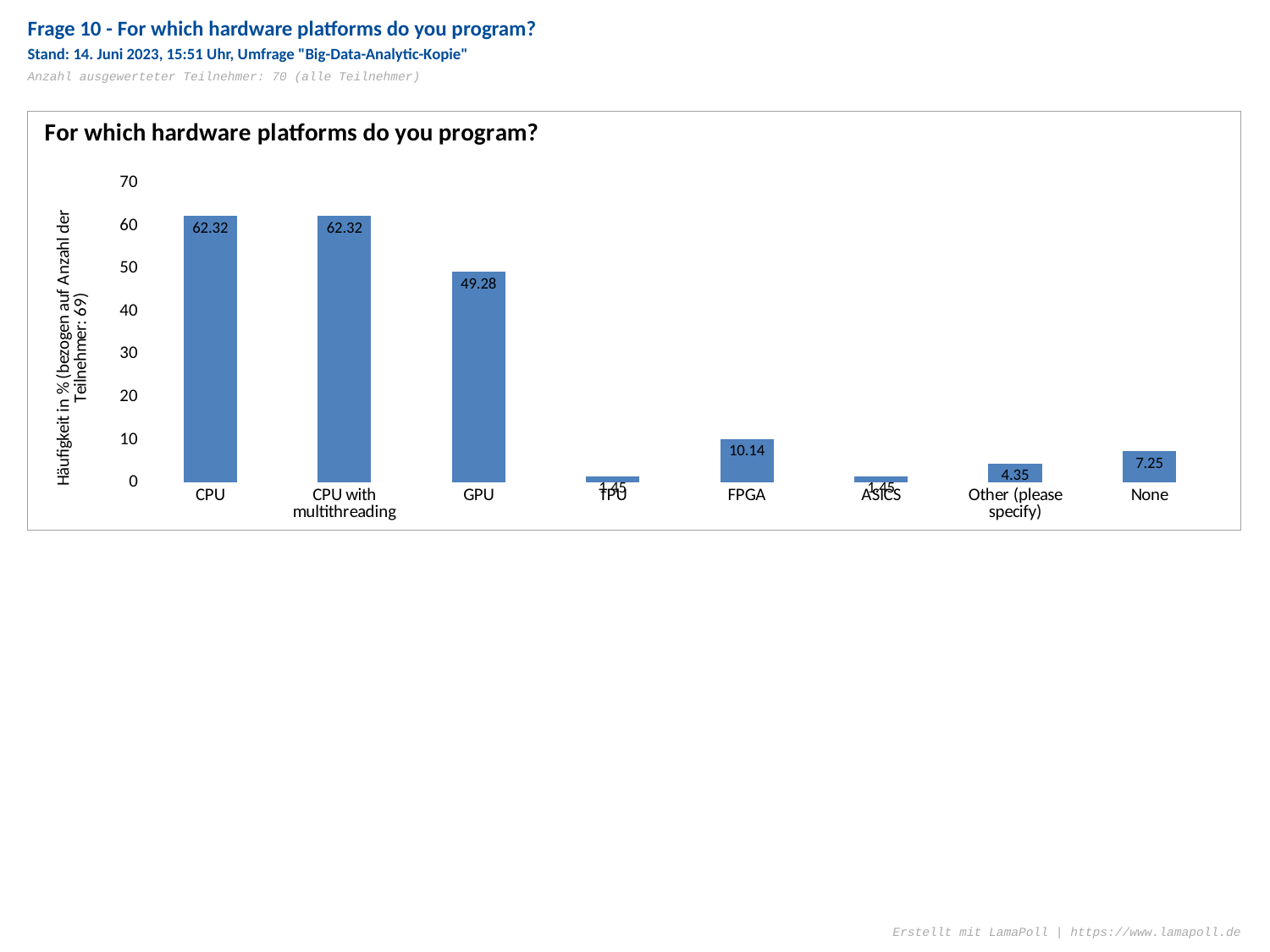
What is the value for FPGA? 10.14 What kind of chart is shown? bar chart What is the difference between the values for CPU and GPU? 13.04 What is the value for Other (please specify)? 4.35 What is the value for GPU? 49.28 What is the value for None? 7.25 Which is larger, the value for GPU or the value for FPGA? GPU What is the difference between the values for FPGA and None? 2.89 What is the title of the chart? For which hardware platforms do you program? Which is larger, the value for None or the value for Other (please specify)? None How many categories are shown on the x axis? 8 What is the value for CPU? 62.32